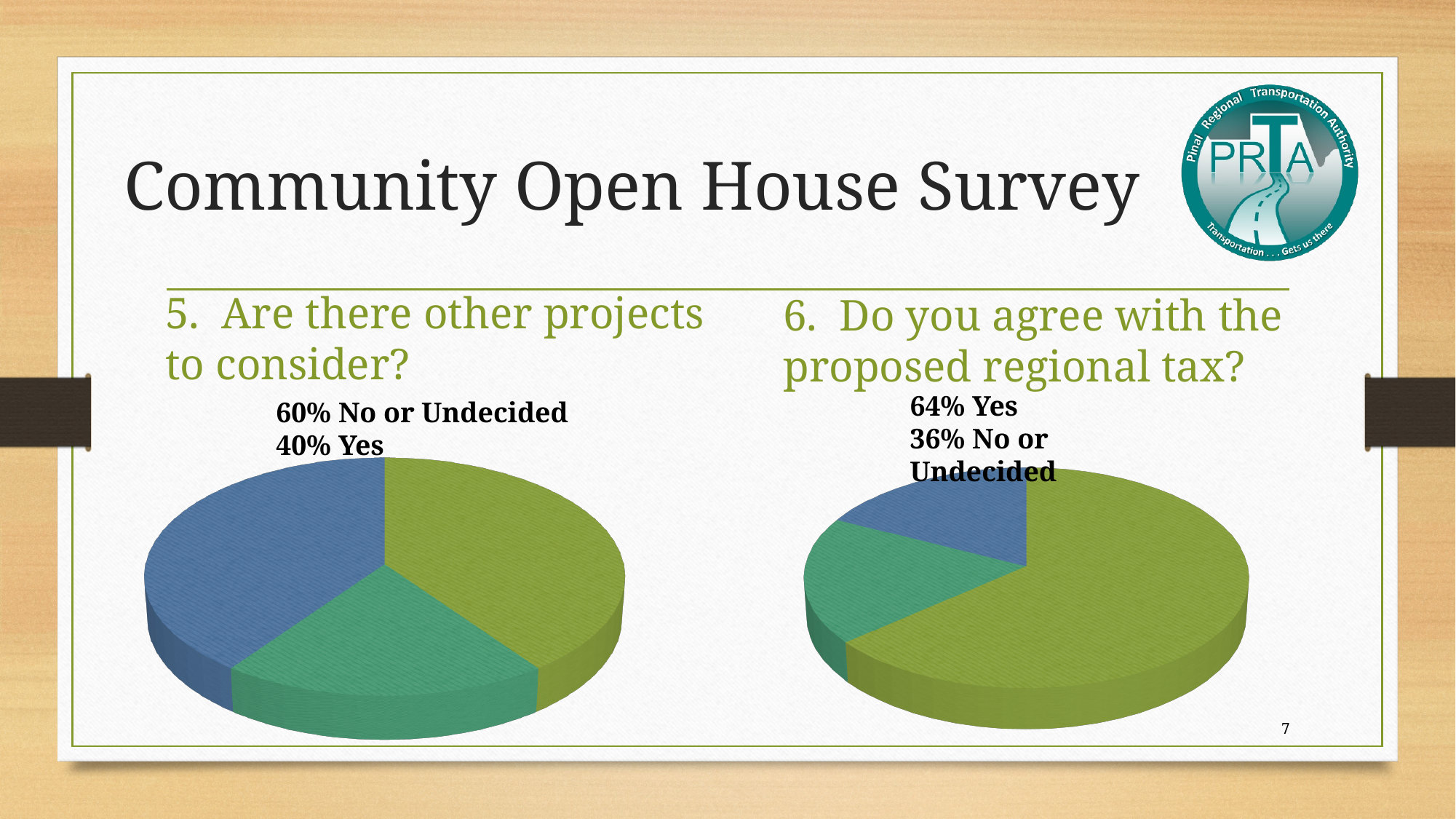
For question 6, "Do you agree with the proposed regional tax?", what percentage answered Yes? 64% What kind of chart is used for question 6, "Do you agree with the proposed regional tax?" Pie chart For question 6, "Do you agree with the proposed regional tax?", by how many percentage points does Yes exceed No or Undecided? 28 percentage points How many slices does the pie chart for question 5, "Are there other projects to consider?", have? 3 For question 5, "Are there other projects to consider?", what percentage answered Yes? 40% For question 6, "Do you agree with the proposed regional tax?", which response was larger, Yes or No or Undecided? Yes For question 5, "Are there other projects to consider?", what percentage answered No or Undecided? 60% For question 6, "Do you agree with the proposed regional tax?", what percentage answered No or Undecided? 36% How many pie charts are shown on the slide? 2 For question 5, "Are there other projects to consider?", which response was larger, Yes or No or Undecided? No or Undecided What kind of chart is used for question 5, "Are there other projects to consider?" Pie chart For question 5, "Are there other projects to consider?", by how many percentage points does No or Undecided exceed Yes? 20 percentage points